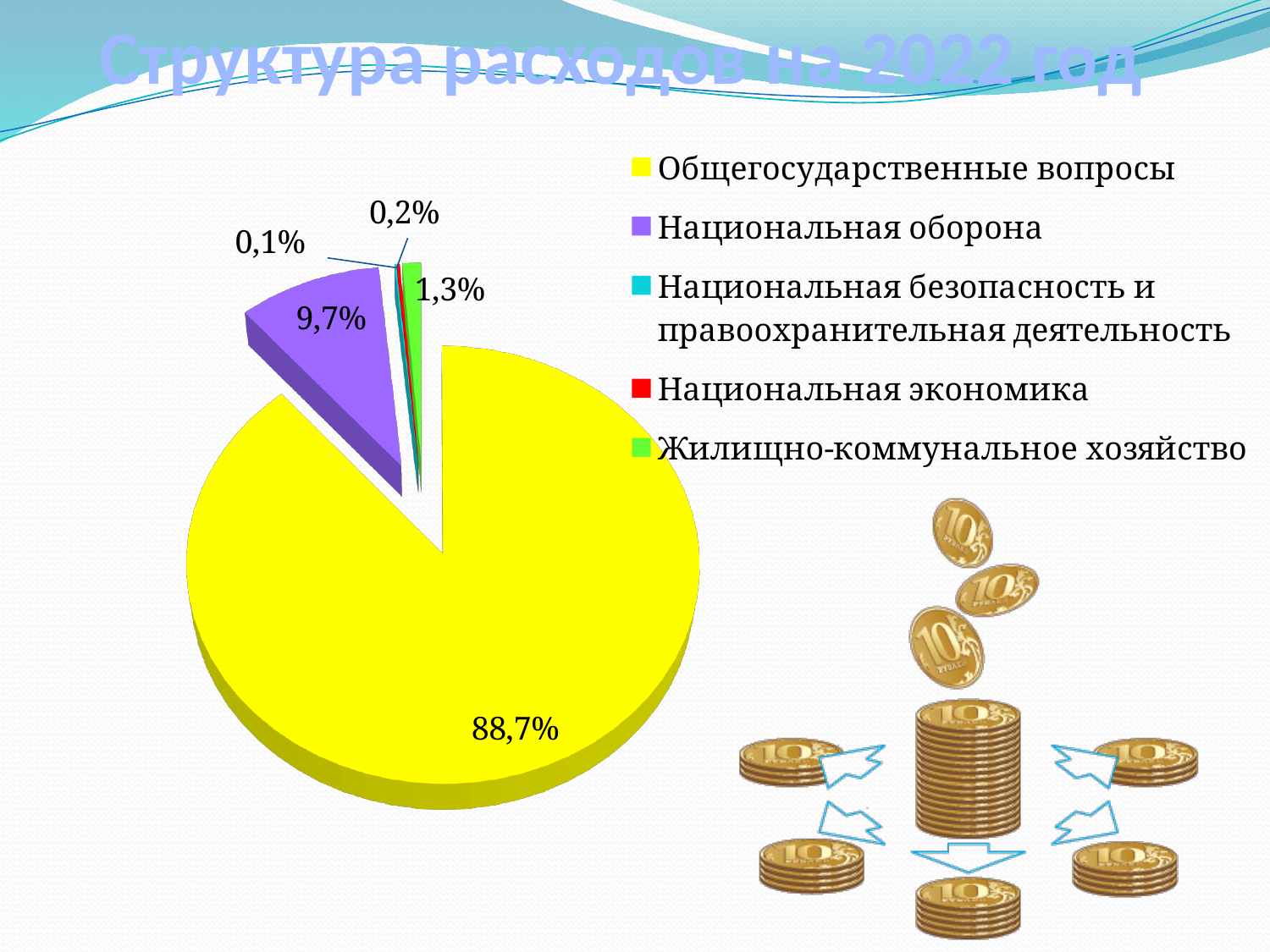
How many categories does the legend list? 5 What share of the pie is Национальная оборона? 9,7% What share of the pie is Национальная безопасность и правоохранительная деятельность? 0,1% What is the title of the chart? Структура расходов на 2022 год Which category has the smallest share of the pie? Национальная безопасность и правоохранительная деятельность What is the difference between the shares for Общегосударственные вопросы and Национальная оборона? 79,0% What share of the pie is Жилищно-коммунальное хозяйство? 1,3% What share of the pie is Национальная экономика? 0,2% Which category has the largest share of the pie? Общегосударственные вопросы What kind of chart is shown on the slide? pie chart What share of the pie is Общегосударственные вопросы? 88,7% Which is larger: the share for Национальная оборона or the share for Жилищно-коммунальное хозяйство? Национальная оборона